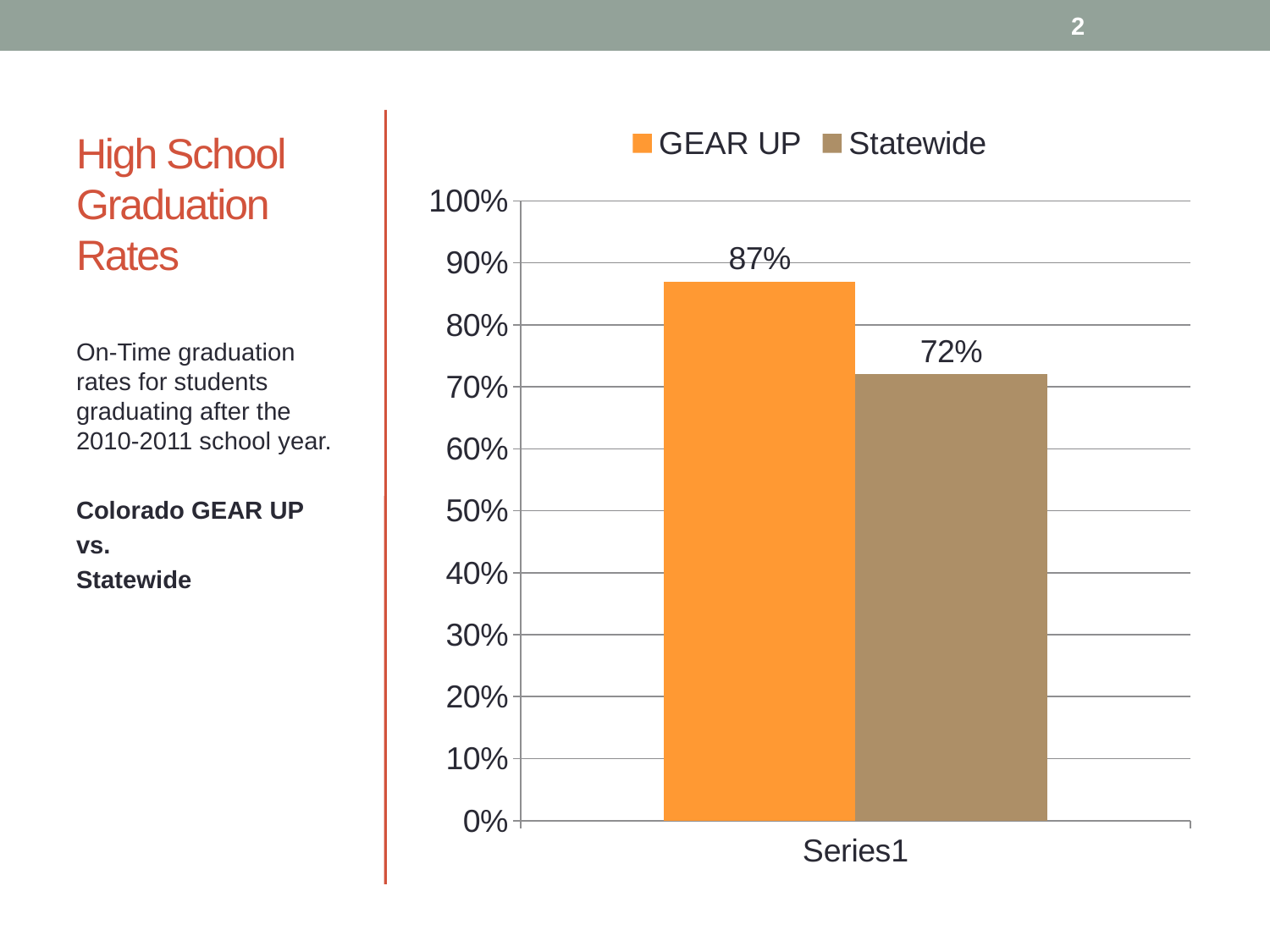
Is the value for GEAR UP greater or less than 80%? greater Which series has the highest value on the chart? GEAR UP What is the label on the x axis category? Series1 What colour is the GEAR UP bar? Orange What is the graduation rate for Statewide? 72% How many series does the legend list? 2 Which series has the higher graduation rate, GEAR UP or Statewide? GEAR UP What is the graduation rate for GEAR UP? 87% What kind of chart is shown on the slide? Bar chart What is the difference between the GEAR UP and Statewide graduation rates? 15% Is the value for Statewide greater or less than 80%? less Which series has the lowest value on the chart? Statewide